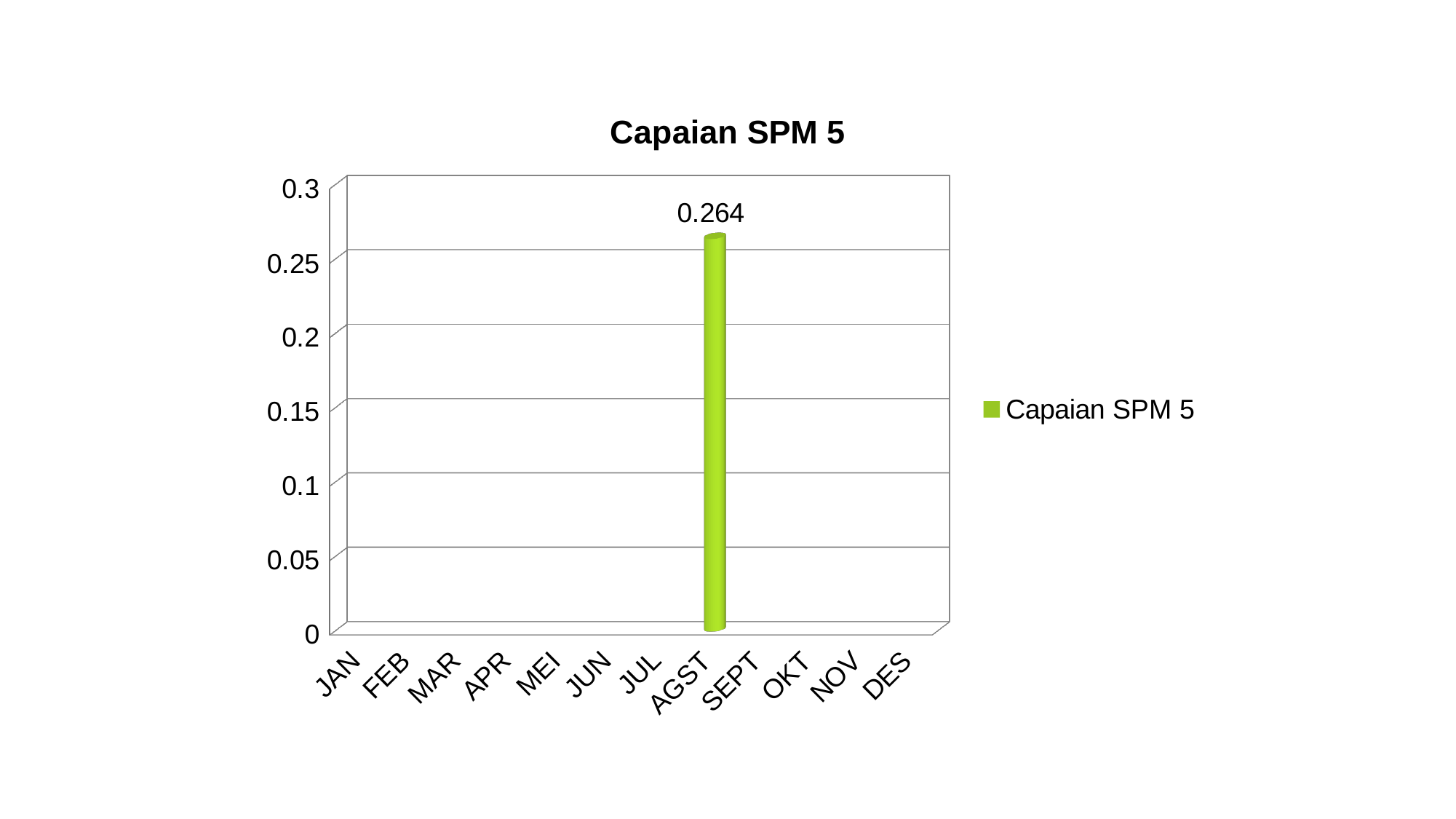
How many series does the legend list? 1 What is the title of the chart? Capaian SPM 5 What is the value for AGST in the Capaian SPM 5 chart? 0.264 How many months have a visible bar in the chart? 1 What is the maximum value shown on the y axis? 0.3 What kind of chart is shown on the slide? bar chart Which month has the highest value in the chart? AGST Is the value for AGST greater or less than 0.3? less How many month categories are shown on the x axis? 12 Is the value for AGST greater or less than 0.25? greater What is the name of the series listed in the legend? Capaian SPM 5